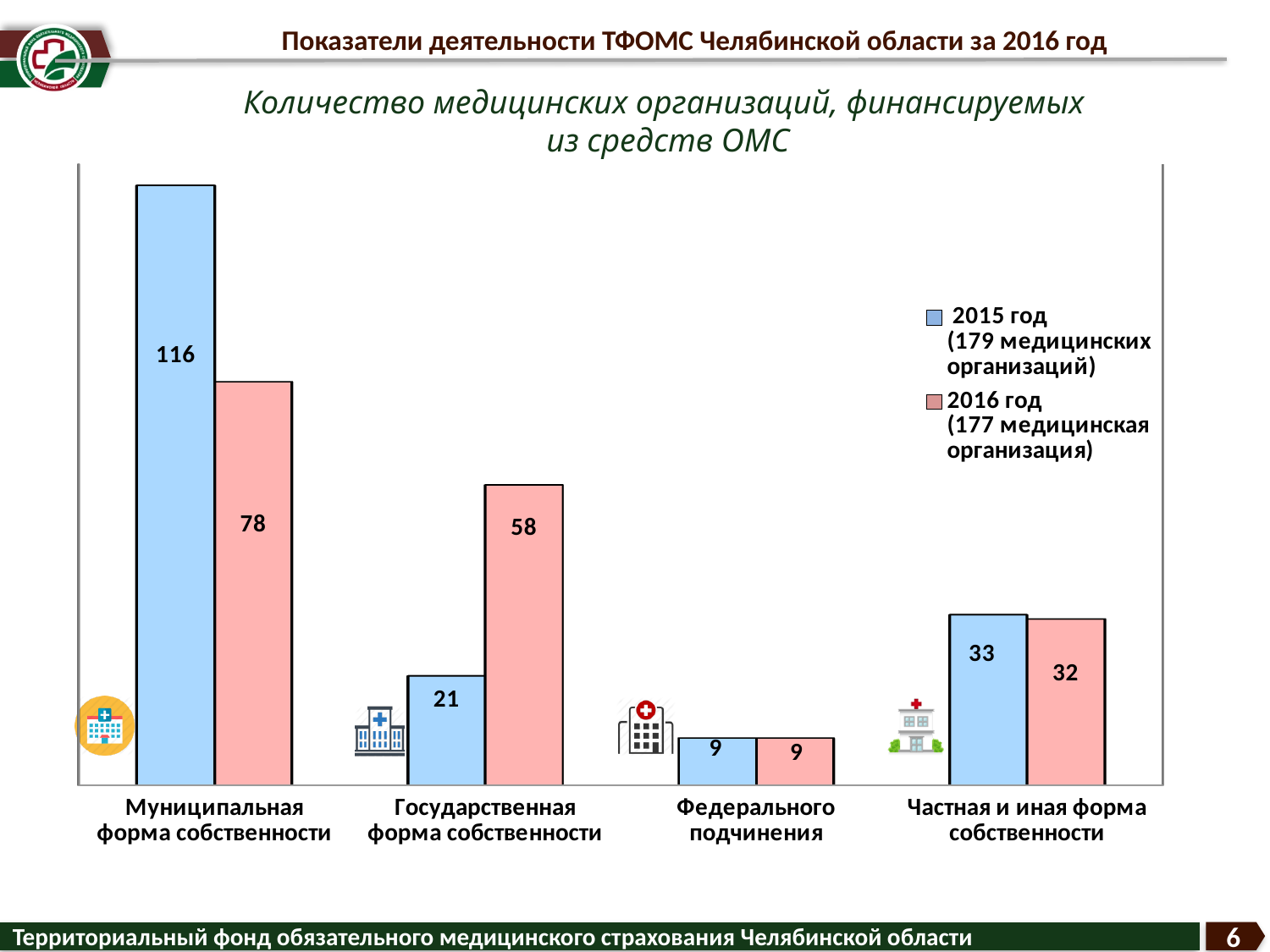
What is the difference between the 2016 год and 2015 год values for Государственная форма собственности? 37 What is the difference between the 2015 год and 2016 год values for Муниципальная форма собственности? 38 What kind of chart is shown on the slide? Bar chart How many series does the legend list? 2 Which category has the highest value in the 2015 год series? Муниципальная форма собственности How many categories are shown on the x axis? 4 Which category has the lowest value in the 2016 год series? Федерального подчинения What is the value for Муниципальная форма собственности in the 2015 год series? 116 What is the value for Государственная форма собственности in the 2016 год series? 58 What is the value for Частная и иная форма собственности in the 2015 год series? 33 According to the legend, how many medical organisations were there in total in 2016 год? 177 Which is larger for Государственная форма собственности: the 2015 год value or the 2016 год value? 2016 год